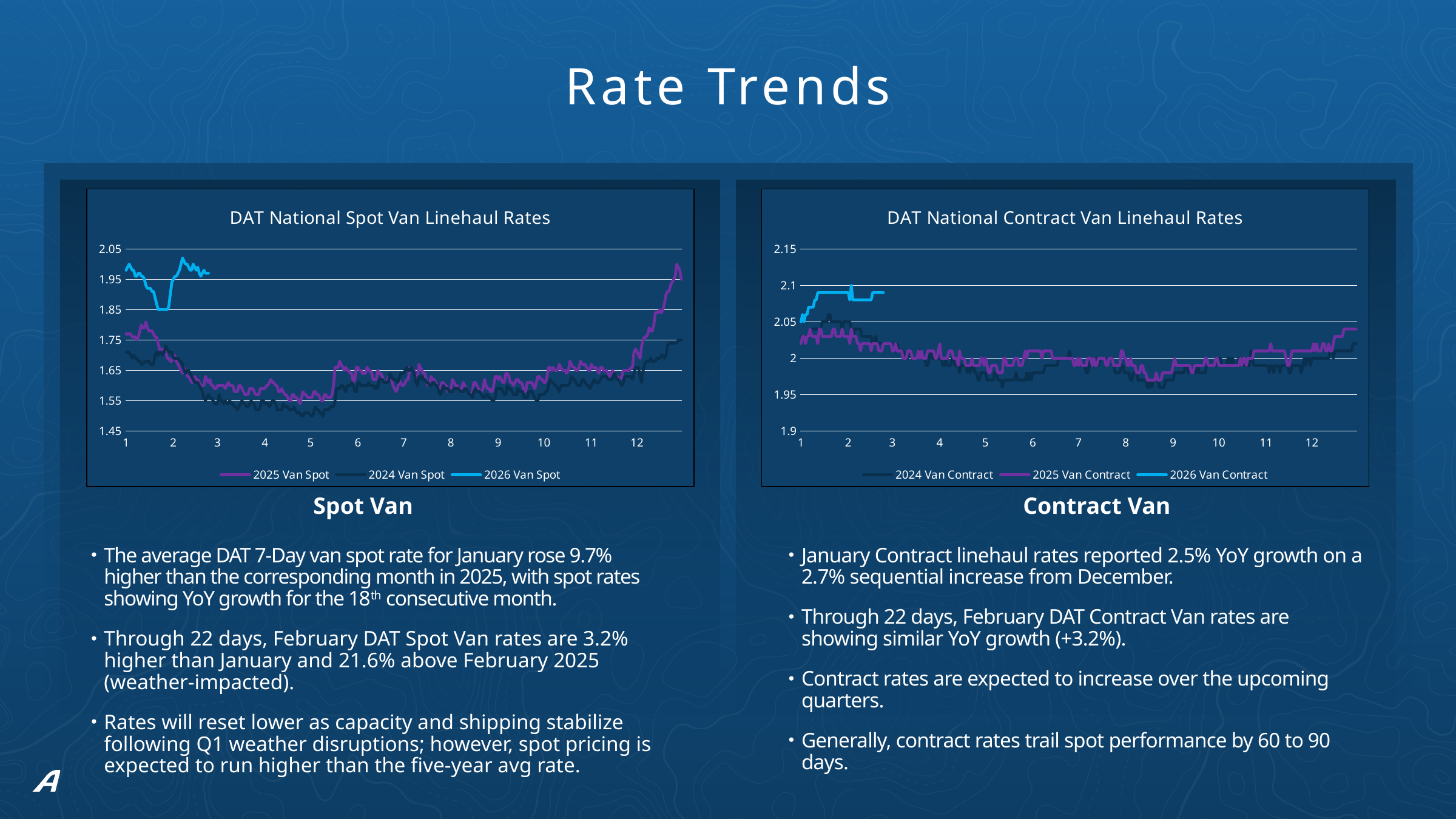
In the DAT National Contract Van Linehaul Rates chart, at month 2, which series is higher: 2026 Van Contract or 2025 Van Contract? 2026 Van Contract In the DAT National Spot Van Linehaul Rates chart, is the 2026 Van Spot value at month 1 greater or less than 1.95? greater In the DAT National Spot Van Linehaul Rates chart, is the 2025 Van Spot value at month 1 greater or less than 1.85? less In the DAT National Spot Van Linehaul Rates chart, at month 1, which series is higher: 2026 Van Spot or 2025 Van Spot? 2026 Van Spot In the DAT National Contract Van Linehaul Rates chart, is the 2025 Van Contract value at month 6 greater or less than 2.05? less How many series does the legend of the DAT National Contract Van Linehaul Rates chart list? 3 In the DAT National Spot Van Linehaul Rates chart, does the 2025 Van Spot line rise or fall from month 10 to month 12? rise What kind of chart is the DAT National Spot Van Linehaul Rates chart? line chart In the DAT National Spot Van Linehaul Rates chart, which series are listed in the legend? 2025 Van Spot, 2024 Van Spot, 2026 Van Spot In the DAT National Contract Van Linehaul Rates chart, does the 2025 Van Contract line rise or fall from month 1 to month 5? fall How many month ticks are shown on the x axis of the DAT National Contract Van Linehaul Rates chart? 12